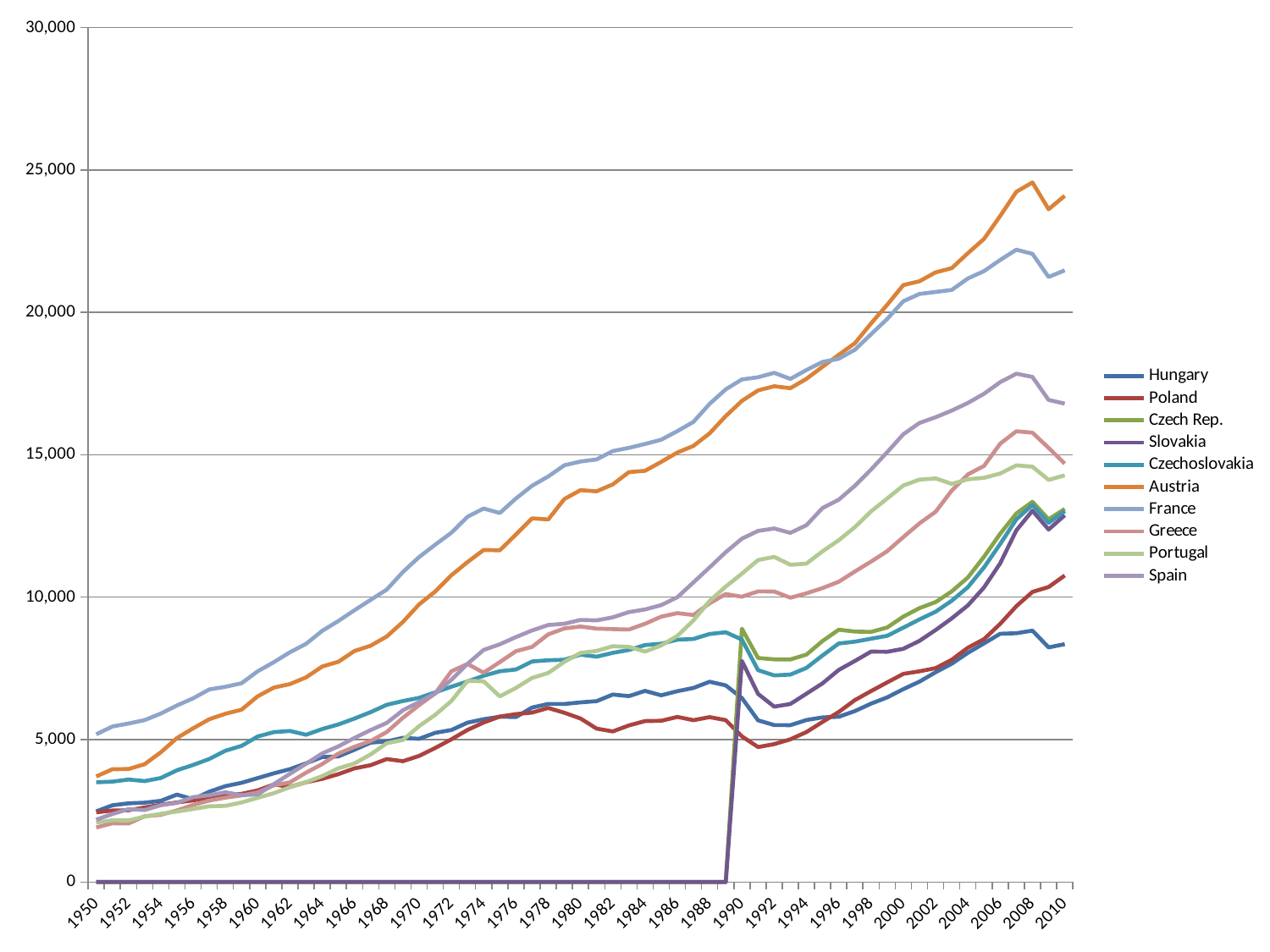
How many series does the legend list? 10 In 2010, which is larger, the value for Poland or the value for Hungary? Poland What kind of chart is shown on the slide? line chart Is the value for Austria in 2010 greater or less than 20,000? greater Is the value for France in 1950 greater or less than 10,000? less Is the value for Spain in 2010 greater or less than 15,000? greater Which series has the highest value in 1950? France In 2010, which is larger, the value for Austria or the value for France? Austria Does the value for Austria generally rise or fall from 1950 to 2010? rise What is the maximum value shown on the vertical axis? 30,000 Which series has the highest value in 2010? Austria